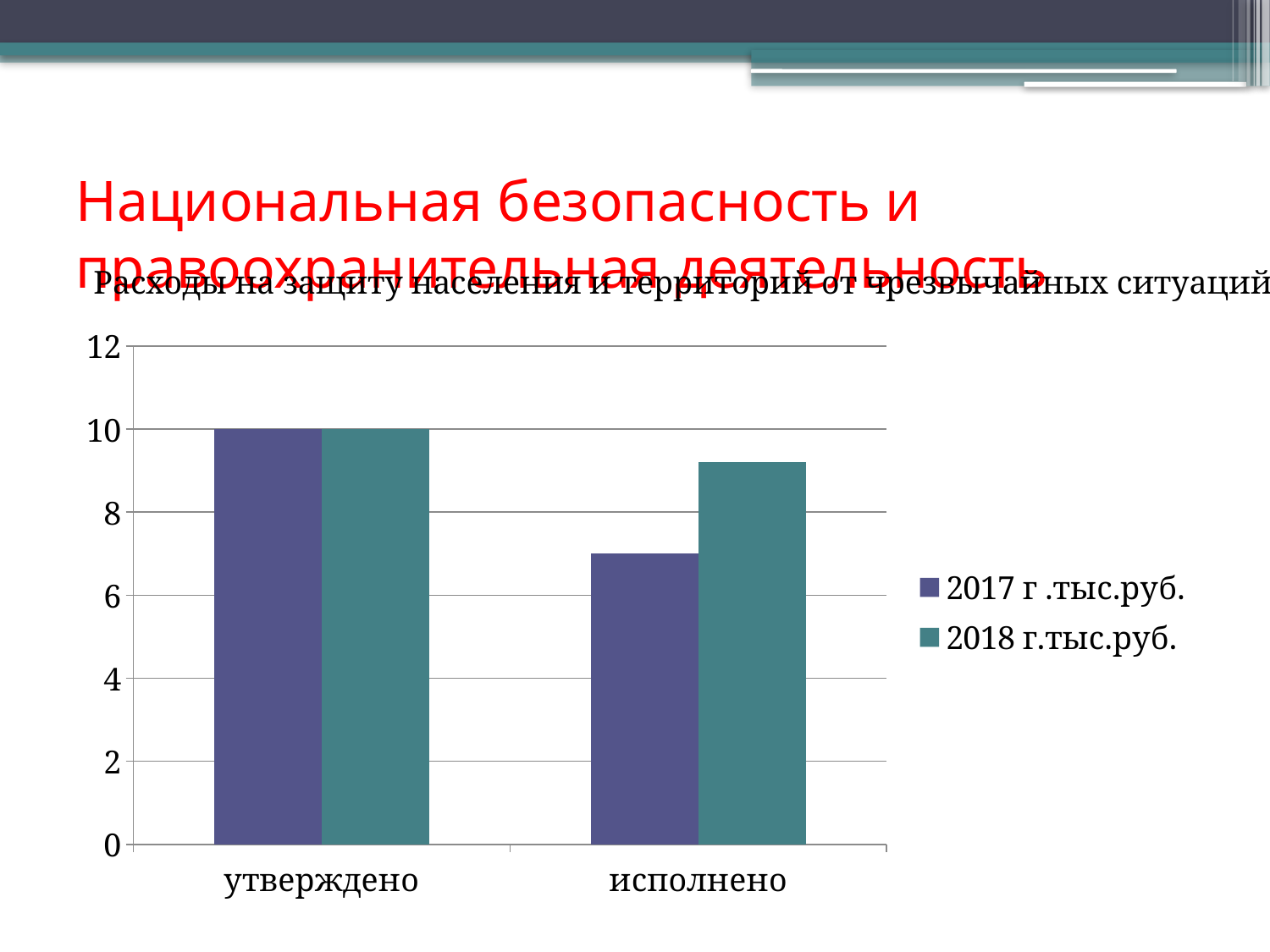
Is the value for 'исполнено' in the '2017 г .тыс.руб.' series greater or less than 8? less What is the value for 'утверждено' in the '2018 г.тыс.руб.' series? 10 In the '2018 г.тыс.руб.' series, which category has the larger value, 'утверждено' or 'исполнено'? утверждено What is the title of the chart? Расходы на защиту населения и территорий от чрезвычайных ситуаций In the '2017 г .тыс.руб.' series, which category has the highest value? утверждено For 'исполнено', which series has the larger value, '2017 г .тыс.руб.' or '2018 г.тыс.руб.'? 2018 г.тыс.руб. What kind of chart is shown on the slide? bar chart What is the value for 'утверждено' in the '2017 г .тыс.руб.' series? 10 Is the value for 'исполнено' in the '2018 г.тыс.руб.' series greater or less than 8? greater How many categories are shown on the x axis of the chart? 2 What are the two entries listed in the chart's legend? 2017 г .тыс.руб. and 2018 г.тыс.руб. How many series does the chart's legend list? 2